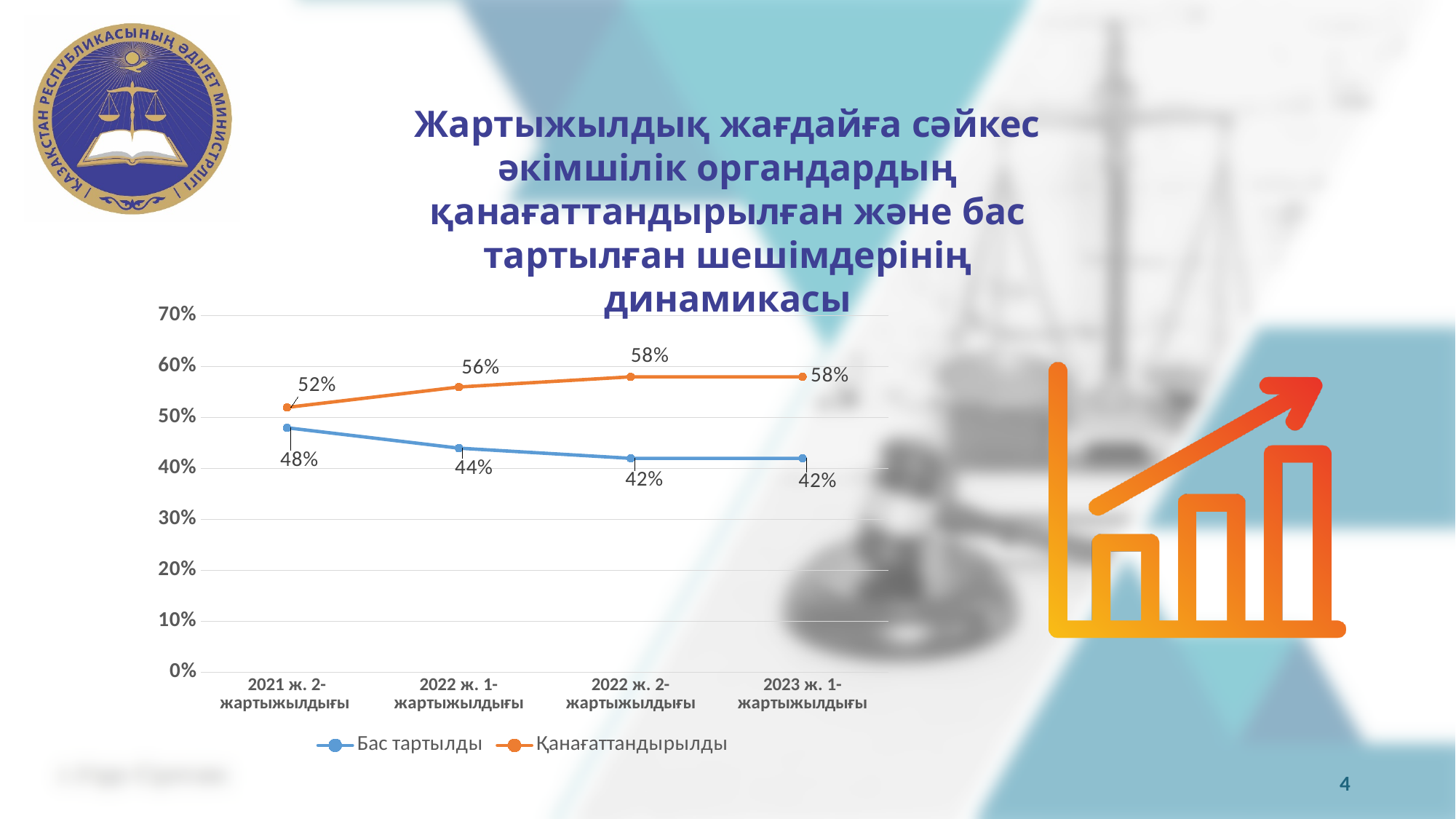
What is the value for Бас тартылды in 2022 ж. 1-жартыжылдығы? 44% What is the difference between Қанағаттандырылды and Бас тартылды in 2022 ж. 2-жартыжылдығы? 16% In which period is the Қанағаттандырылды series lowest? 2021 ж. 2-жартыжылдығы What is the value for Қанағаттандырылды in 2021 ж. 2-жартыжылдығы? 52% What type of chart is shown on the slide? line chart Which colour is used for the Қанағаттандырылды series? orange Which series has the larger value in 2022 ж. 1-жартыжылдығы, Бас тартылды or Қанағаттандырылды? Қанағаттандырылды Does the Бас тартылды series rise or fall from 2021 ж. 2-жартыжылдығы to 2023 ж. 1-жартыжылдығы? fall What is the value for Қанағаттандырылды in 2023 ж. 1-жартыжылдығы? 58% In which period is the Бас тартылды series highest? 2021 ж. 2-жартыжылдығы How many periods are shown on the x axis? 4 How many series does the legend list? 2